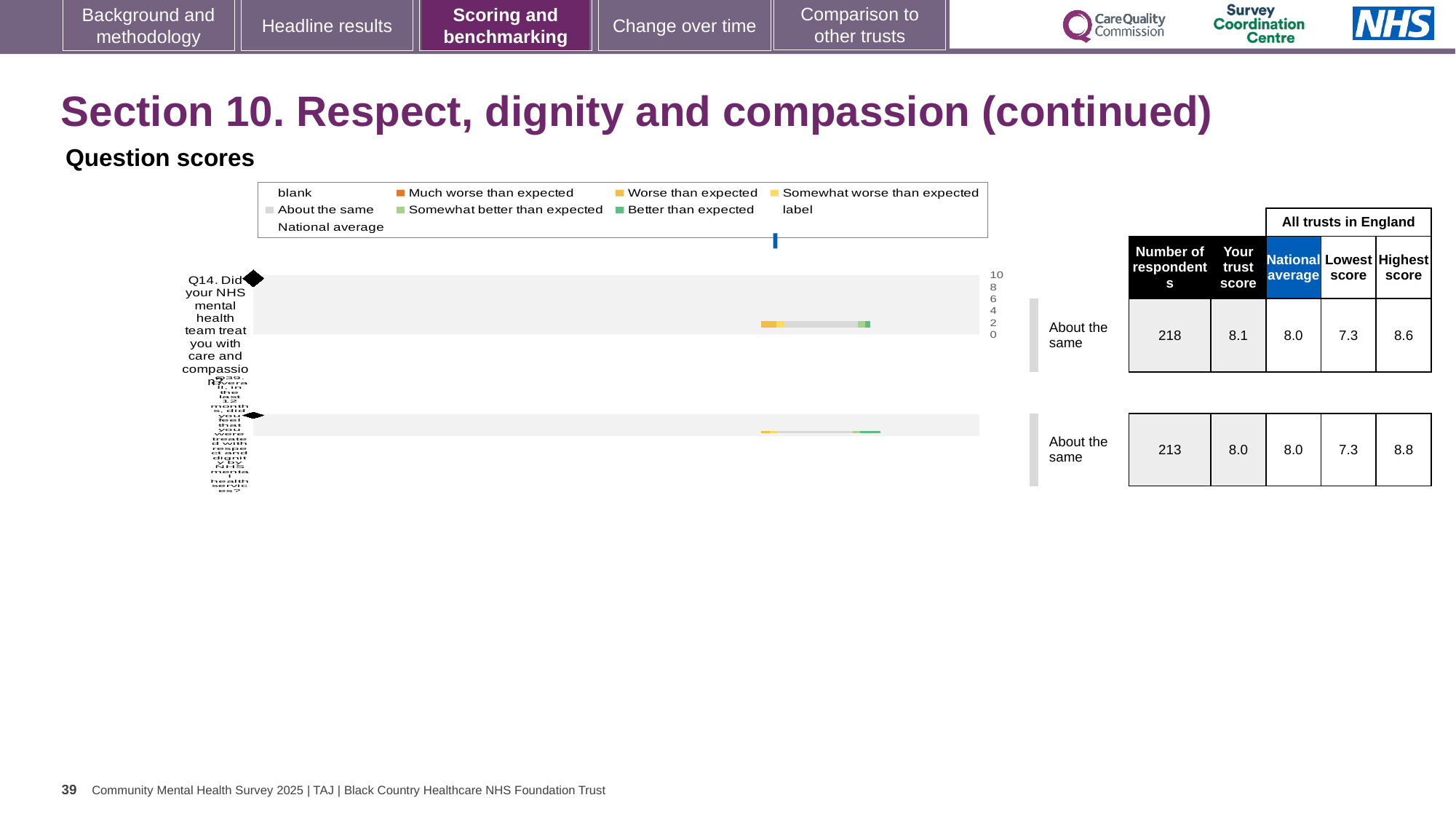
What colour does the legend use for 'Better than expected'? Green How many more respondents answered Q14 than the second question plotted (Q39)? 5 What kind of chart is used to show the question scores on this slide? Bar chart For Q14, which is larger: the trust score or the national average? Trust score For Q14, what is the difference between the highest score and the lowest score among all trusts in England? 1.3 How many questions are plotted in the question scores chart? 2 What is the national average for Q14 (Did your NHS mental health team treat you with care and compassion?)? 8.0 What is the highest score among all trusts in England for the second question plotted (Q39)? 8.8 What is the lowest score among all trusts in England for the second question plotted (Q39)? 7.3 How many respondents are shown for Q14 (Did your NHS mental health team treat you with care and compassion?)? 218 What is the trust score for Q14 (Did your NHS mental health team treat you with care and compassion?)? 8.1 What benchmark category is shown for Q14 (Did your NHS mental health team treat you with care and compassion?)? About the same